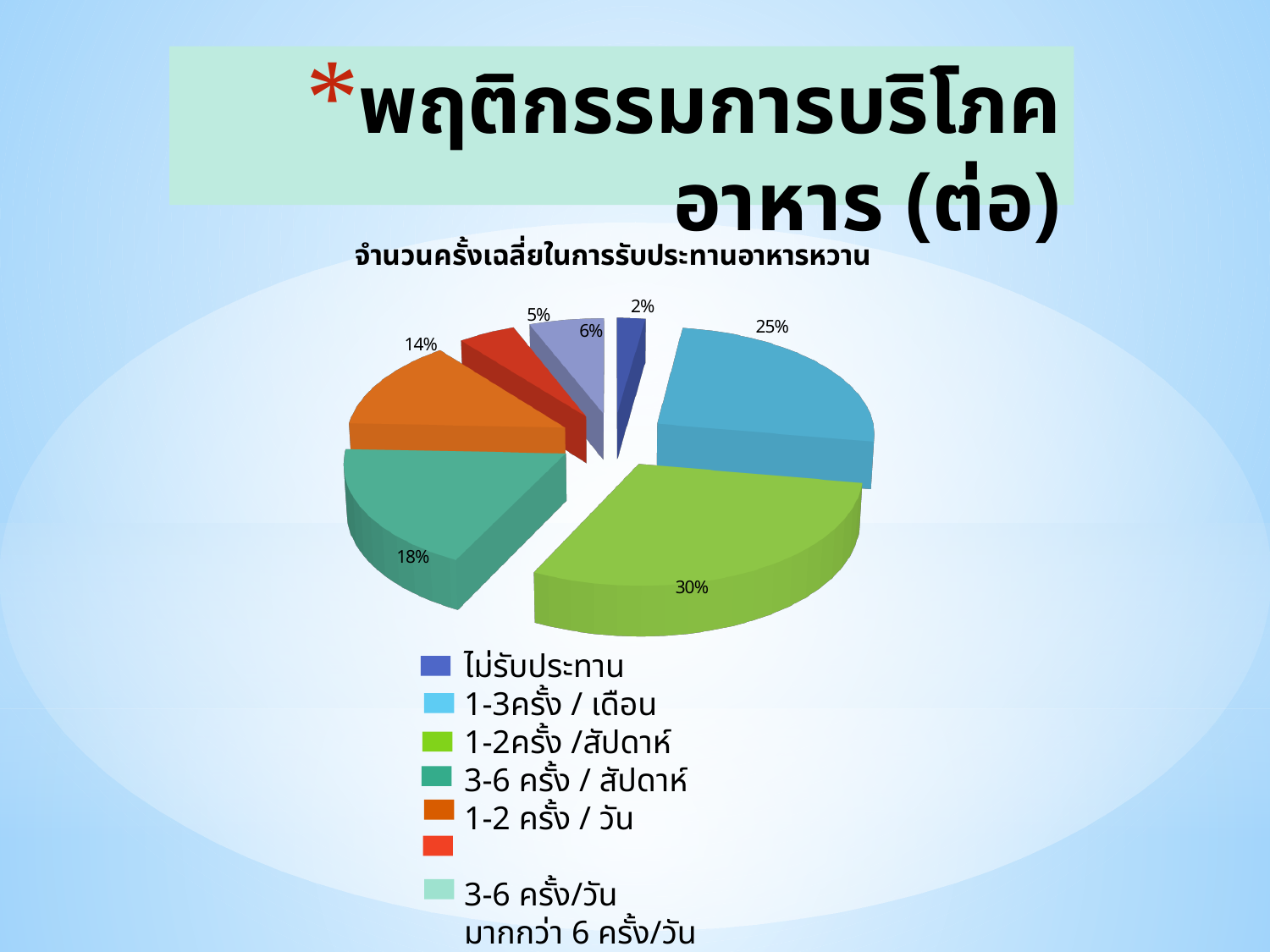
What percentage is shown for 1-3ครั้ง / เดือน? 25% Which category has the smallest share of the pie? ไม่รับประทาน What is the difference in percentage points between 1-2ครั้ง /สัปดาห์ and 1-3ครั้ง / เดือน? 5 Which category has the largest share of the pie? 1-2ครั้ง /สัปดาห์ What percentage is shown for ไม่รับประทาน? 2% What percentage is shown for 3-6 ครั้ง / สัปดาห์? 18% What is the title of the chart? จำนวนครั้งเฉลี่ยในการรับประทานอาหารหวาน How many slices does the pie chart have? 7 What percentage is shown for 1-2ครั้ง /สัปดาห์? 30% What percentage is shown for 1-2 ครั้ง / วัน? 14% What kind of chart is shown on the slide? Pie chart Which is larger, the share for 3-6 ครั้ง / สัปดาห์ or the share for 1-2 ครั้ง / วัน? 3-6 ครั้ง / สัปดาห์